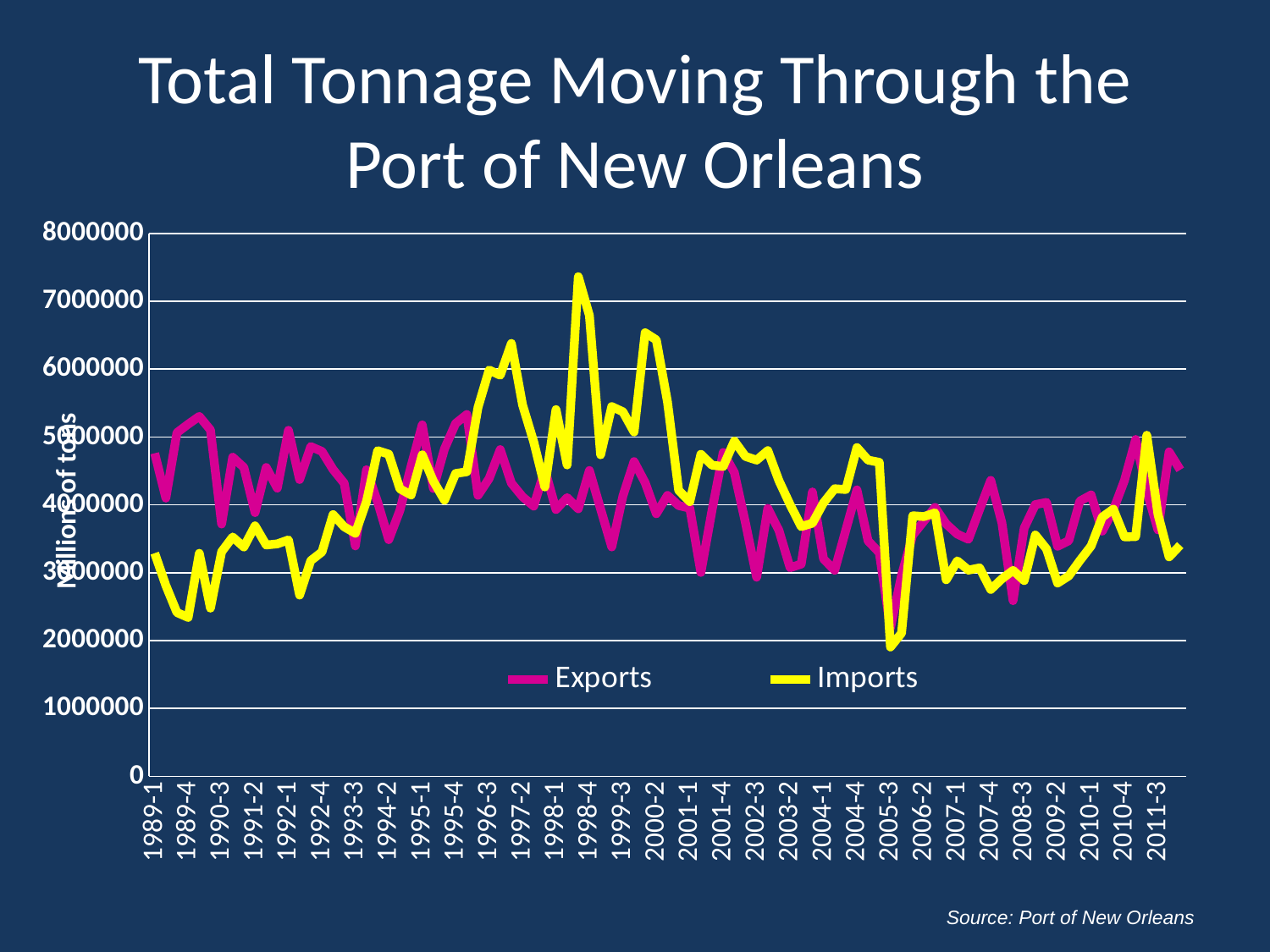
At 1989-4, which series has the larger value, Exports or Imports? Exports How many series does the legend list? 2 Is the Imports value at 1998-4 greater or less than 6000000? greater Is the Imports value at 2005-3 greater or less than 3000000? less Which colour is used for the Imports line? yellow At 1998-4, which series has the larger value, Exports or Imports? Imports What kind of chart is shown on the slide? line chart Which series reaches the highest value anywhere on the chart, Exports or Imports? Imports What is the source cited for the chart? Port of New Orleans Is the Exports value at 1989-1 greater or less than 4000000? greater Which series drops to the lowest value anywhere on the chart, Exports or Imports? Imports